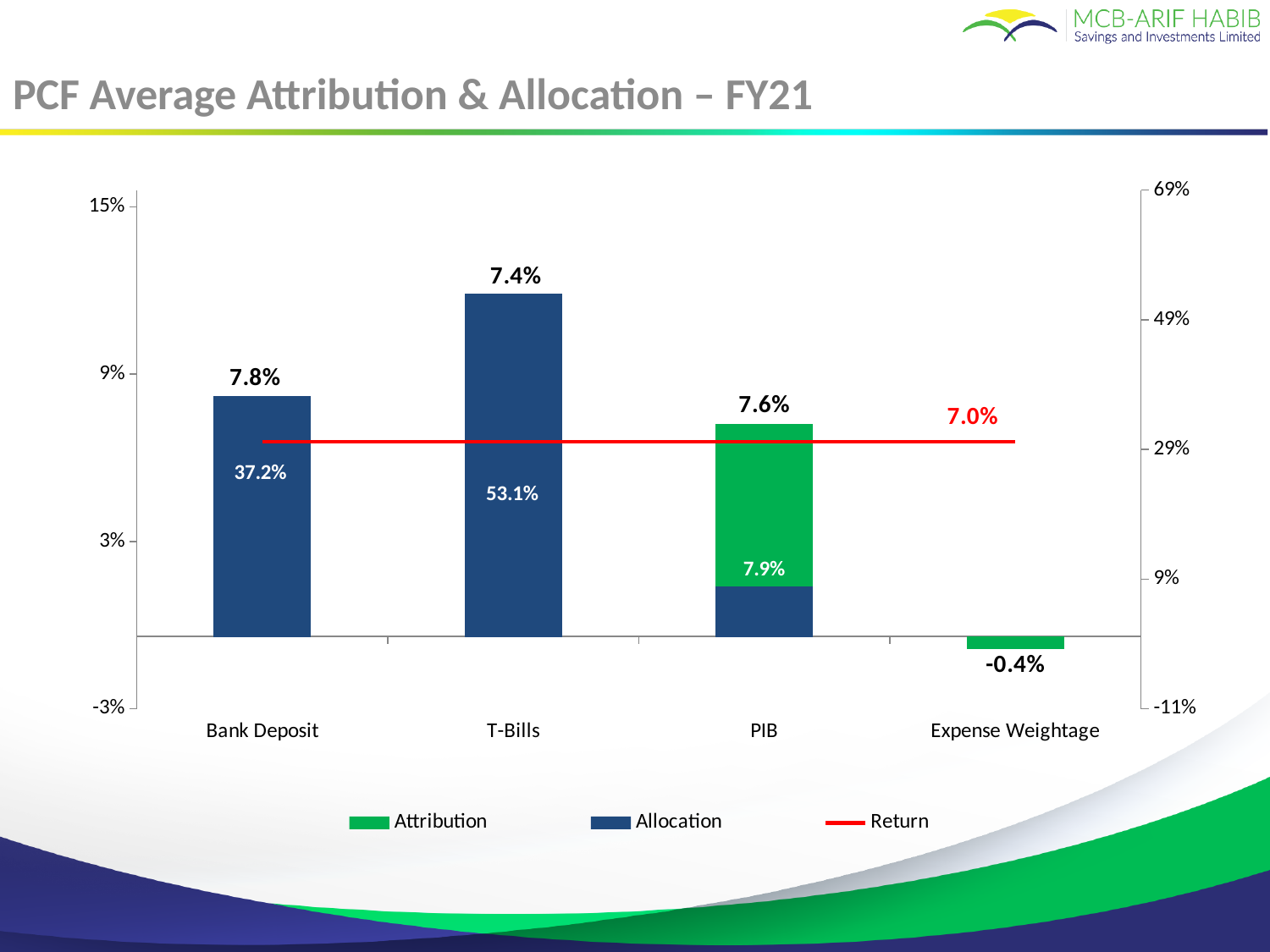
What is the difference between the Allocation values for T-Bills and Bank Deposit? 15.9% What is the Attribution value for Expense Weightage? -0.4% Which category has the highest Allocation value? T-Bills How many categories are shown on the x axis? 4 What is the title of the chart? PCF Average Attribution & Allocation – FY21 What value is labelled on the Return line? 7.0% Which category has the lowest Attribution value? Expense Weightage What is the Allocation value for T-Bills? 53.1% What is the Allocation value for Bank Deposit? 37.2% How many series does the legend list? 3 Which is larger, the Allocation value for Bank Deposit or for PIB? Bank Deposit What is the Attribution value for PIB? 7.6%